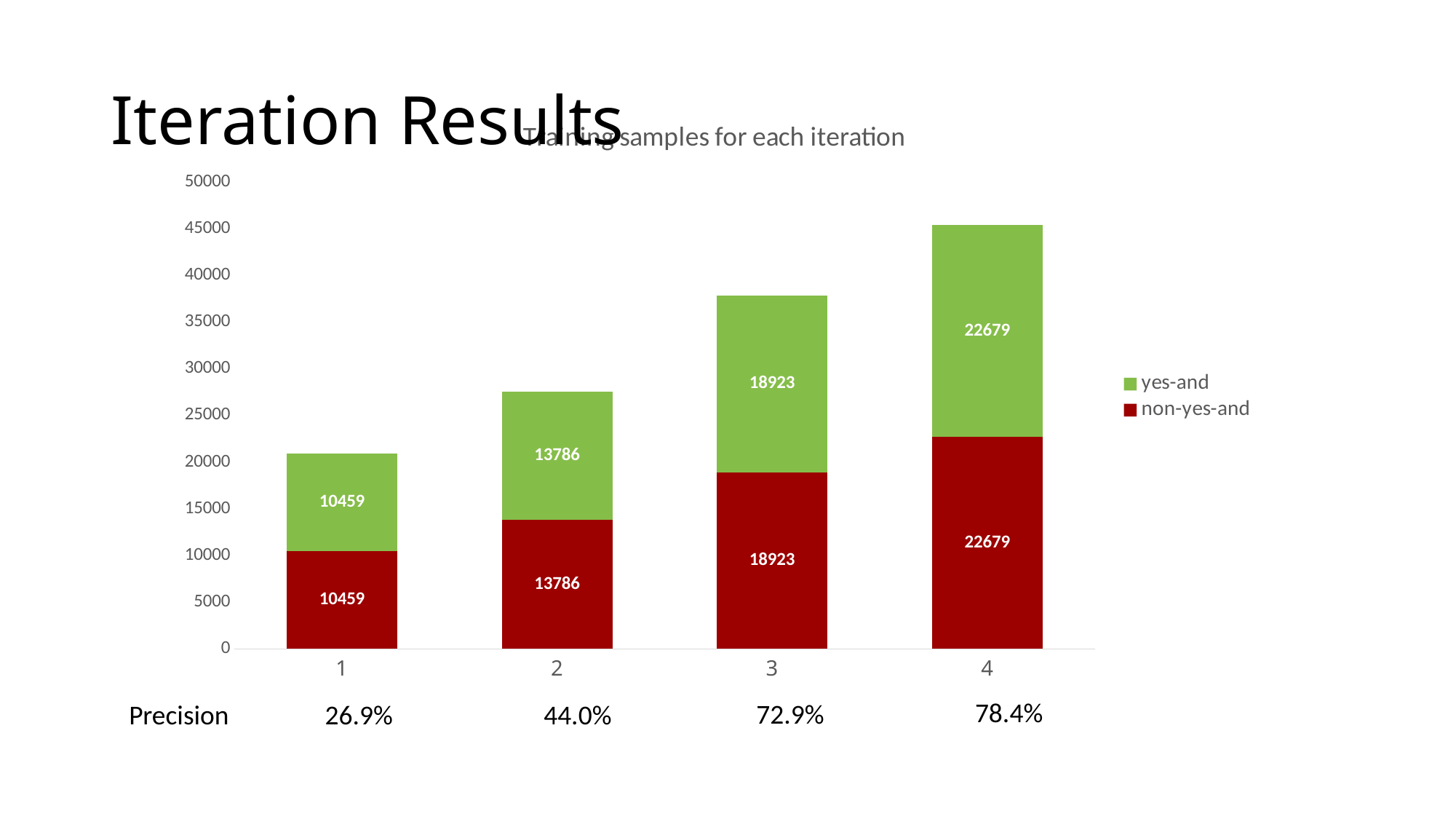
Which iteration has the lowest yes-and value? 1 What is the total height of the stacked bar for iteration 1? 20918 What is the yes-and value for iteration 1? 10459 What is the yes-and value for iteration 3? 18923 How many series does the legend list? 2 Which is larger, the non-yes-and value for iteration 3 or for iteration 2? iteration 3 Which iteration has the highest non-yes-and value? 4 What is the difference between the yes-and values for iteration 4 and iteration 1? 12220 What kind of chart is shown? stacked bar chart What is the total height of the stacked bar for iteration 4? 45358 How many iterations are shown on the x axis? 4 What is the non-yes-and value for iteration 2? 13786